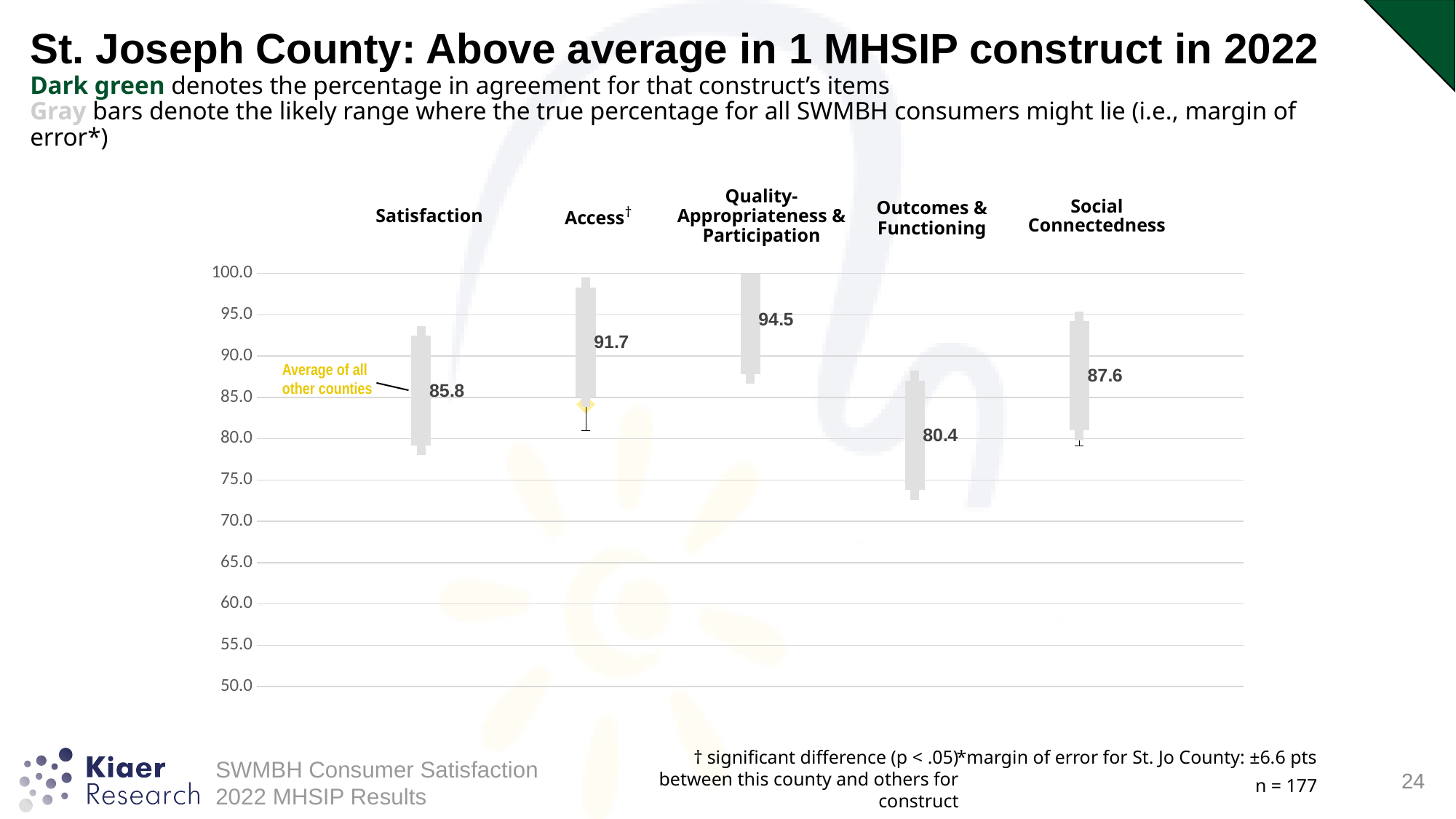
What value is labeled for Satisfaction on the chart? 85.8 Which construct has the lowest labeled value on the chart? Outcomes & Functioning What value is labeled for Access on the chart? 91.7 How many constructs are shown on the chart? 5 What value is labeled for Quality-Appropriateness & Participation on the chart? 94.5 What is the lowest value shown on the chart's vertical axis? 50.0 Which has a larger labeled value, Social Connectedness or Outcomes & Functioning? Social Connectedness What value is labeled for Outcomes & Functioning on the chart? 80.4 Which construct has the highest labeled value on the chart? Quality-Appropriateness & Participation What is the difference between the labeled values for Access and Satisfaction? 5.9 Which construct is marked with a dagger (†) indicating a significant difference? Access What value is labeled for Social Connectedness on the chart? 87.6